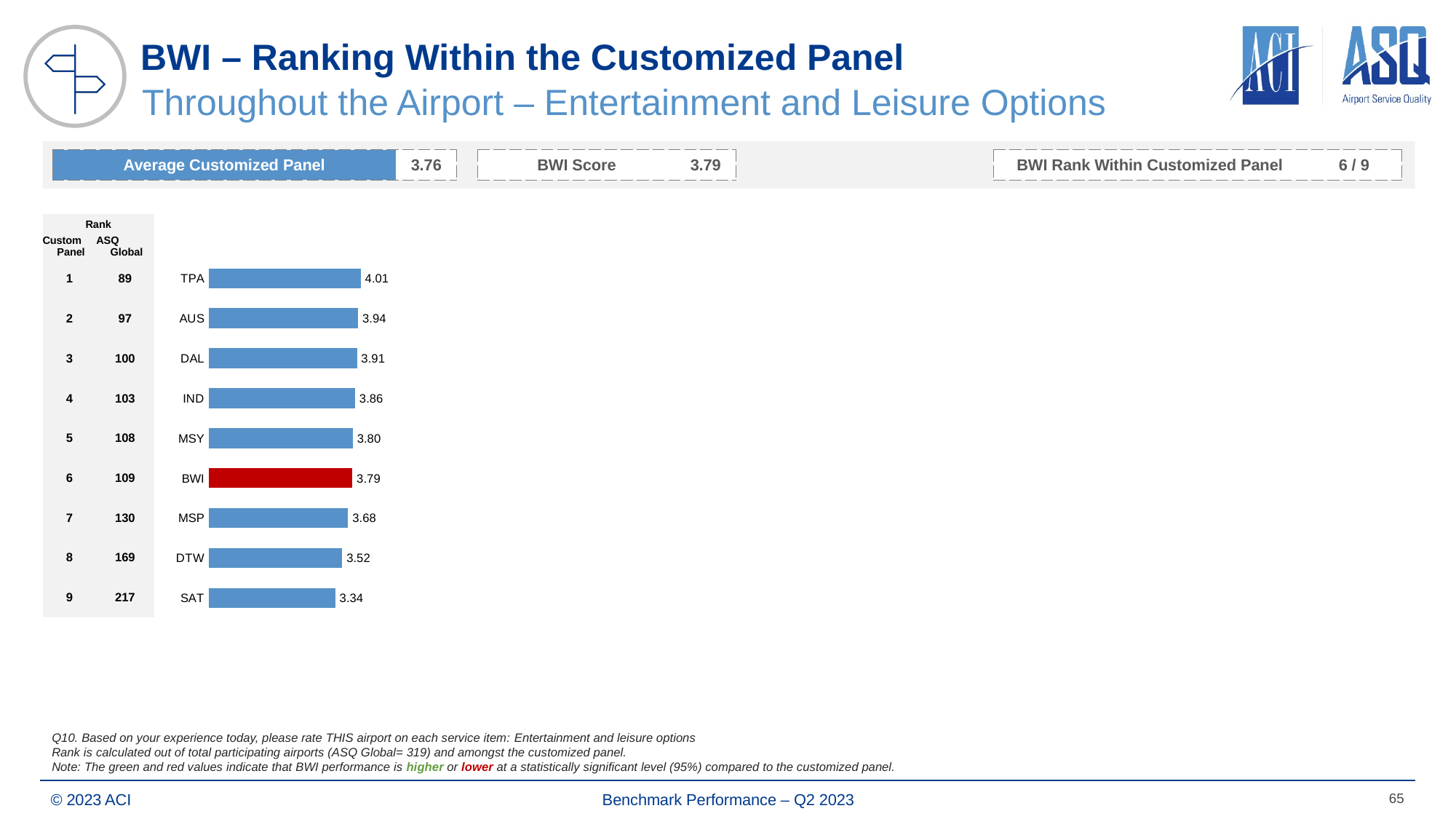
Which airport has the highest value? TPA What is the difference between the values for TPA and SAT? 0.67 What is the value for DTW? 3.52 Which is larger, the value for AUS or the value for DAL? AUS What is the value for TPA? 4.01 What is the difference between the values for BWI and MSP? 0.11 How many airports are shown in the chart? 9 What is the value for BWI? 3.79 Which bar is coloured red? BWI What kind of chart is shown? bar chart Which is larger, the value for MSY or the value for DTW? MSY Which airport has the lowest value? SAT